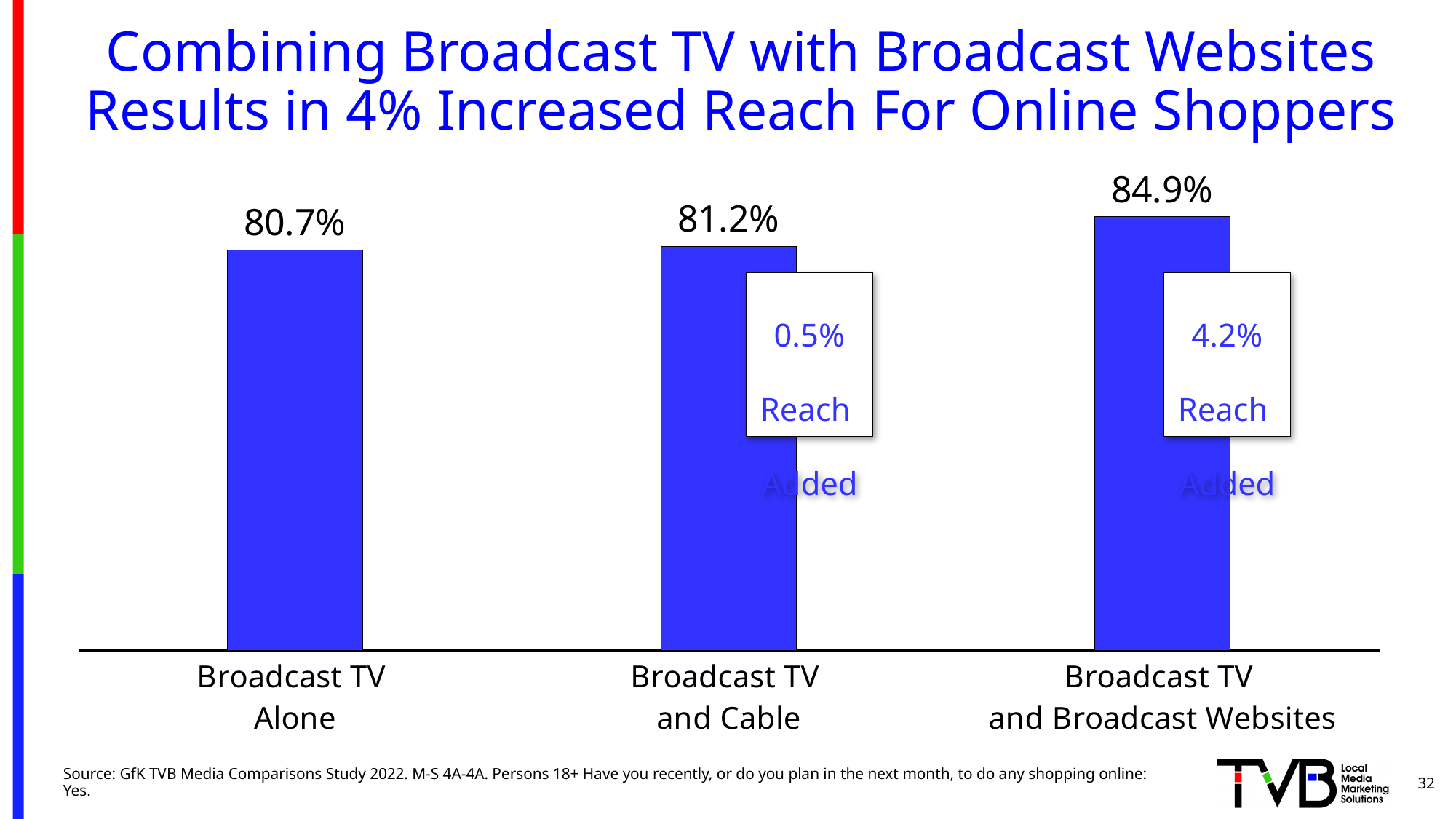
Which category has the lowest value? Broadcast TV Alone Which category has the highest value? Broadcast TV and Broadcast Websites What reach added is shown in the callout box next to the Broadcast TV and Cable bar? 0.5% Which is larger, the value for Broadcast TV and Cable or the value for Broadcast TV and Broadcast Websites? Broadcast TV and Broadcast Websites What is the value for Broadcast TV and Broadcast Websites? 84.9% What is the value for Broadcast TV and Cable? 81.2% Do the values rise or fall from left to right across the categories? rise What is the value for Broadcast TV Alone? 80.7% What is the difference between the values for Broadcast TV and Broadcast Websites and Broadcast TV Alone? 4.2% What is the difference between the values for Broadcast TV and Cable and Broadcast TV Alone? 0.5% How many categories are shown in the chart? 3 What kind of chart is shown on the slide? bar chart